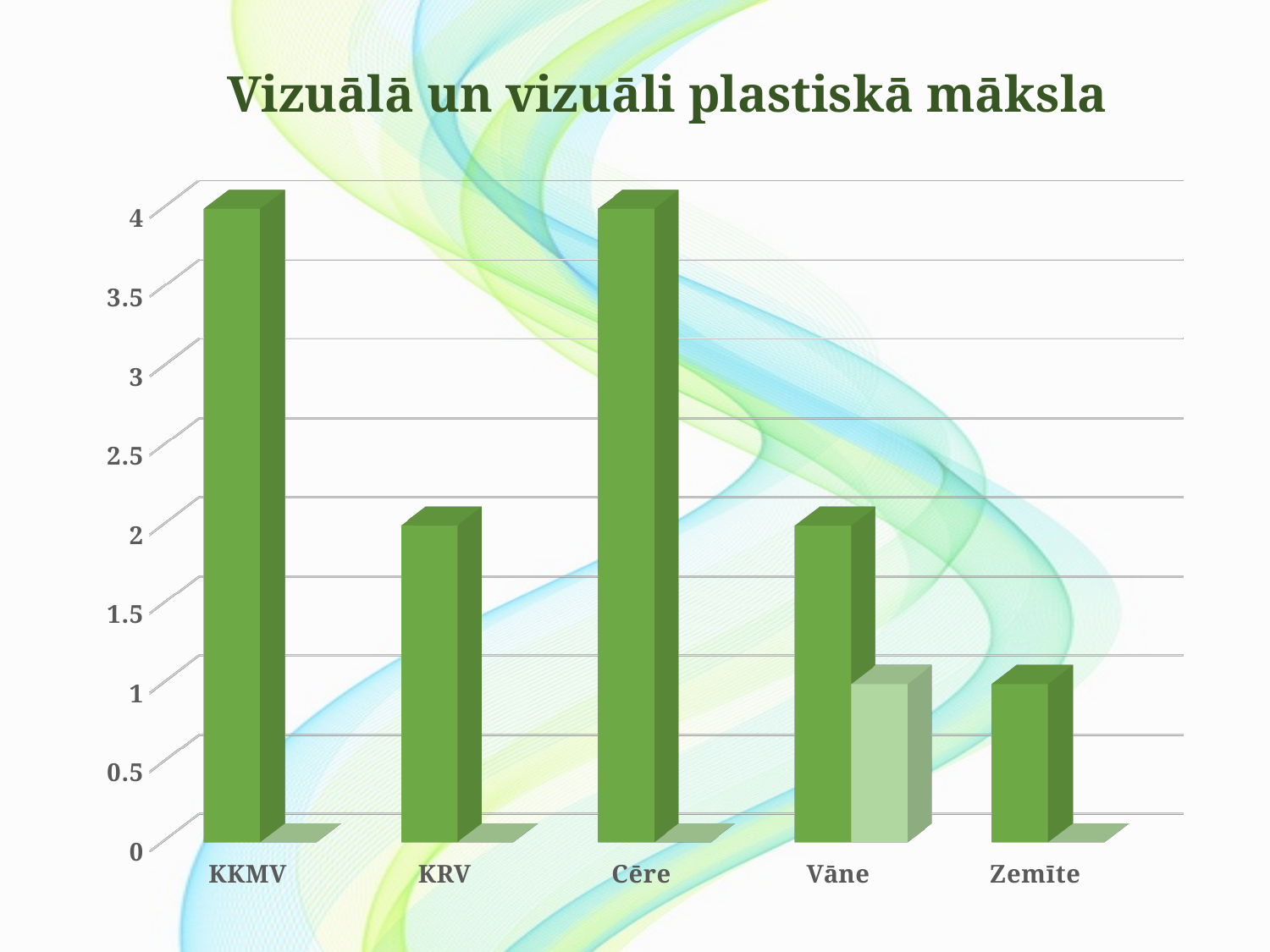
What is the title of the chart? Vizuālā un vizuāli plastiskā māksla What is the value for KRV? 2 What is the value for KKMV? 4 What is the value for Zemīte? 1 Which is larger, the value for KRV or the value for Zemīte? KRV What is the value of the taller (dark green) bar for Vāne? 2 What is the difference between the values for KKMV and KRV? 2 How many categories are shown on the x axis? 5 What is the value for Cēre? 4 Which two categories share the highest value in the chart? KKMV and Cēre What is the value of the shorter (light green) bar for Vāne? 1 What kind of chart is shown on the slide? bar chart